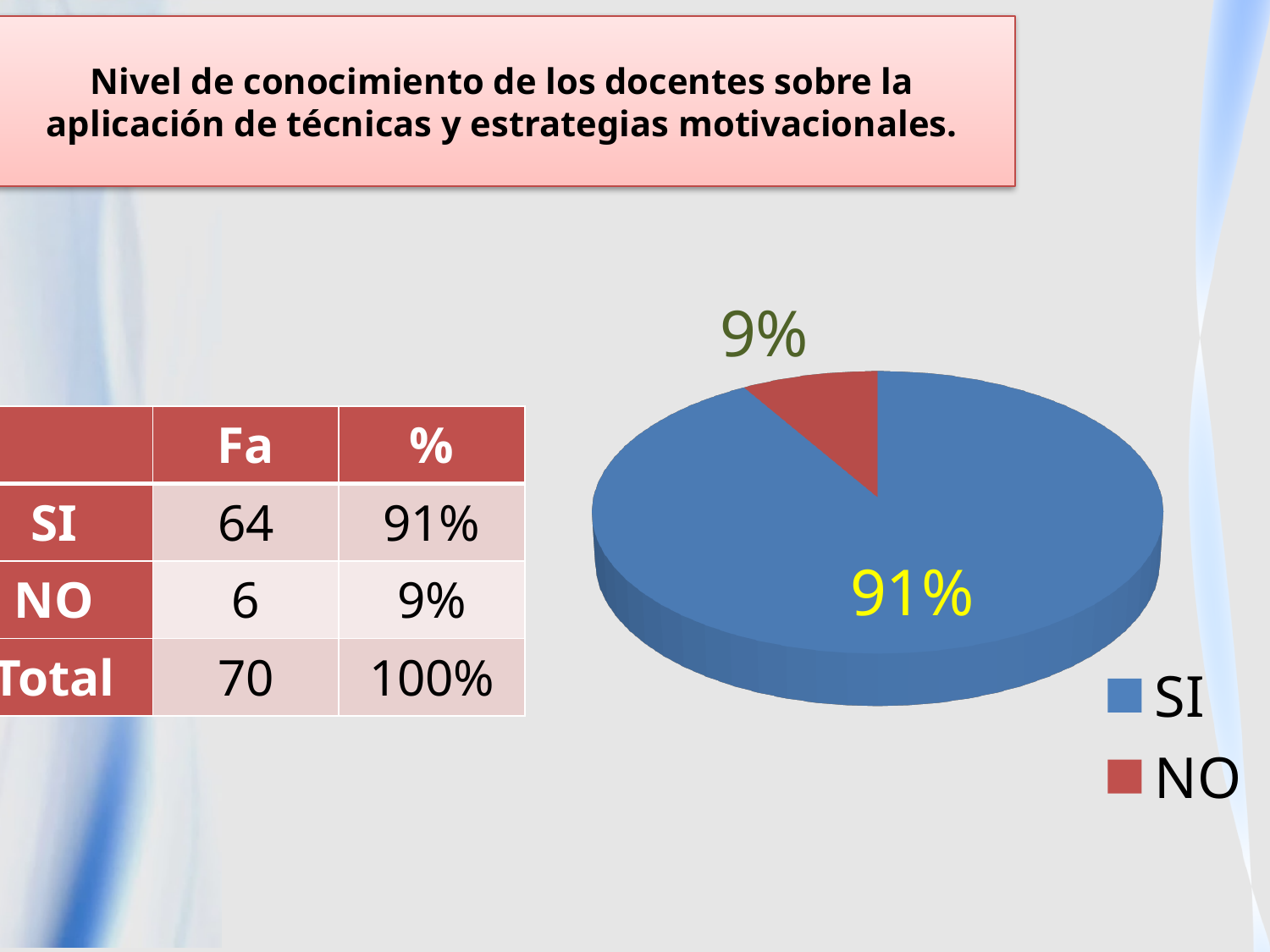
Which slice is larger, SI or NO? SI What share of the pie does the SI slice represent? 91% What colour is the NO slice in the pie chart? red What share of the pie does the NO slice represent? 9% Which category has the largest slice of the pie? SI Which category has the smallest slice of the pie? NO How many entries does the legend list? 2 What colour is the SI slice in the pie chart? blue What kind of chart is shown on the slide? pie chart How many slices does the pie chart have? 2 What is the difference in percentage points between the SI and NO slices? 82